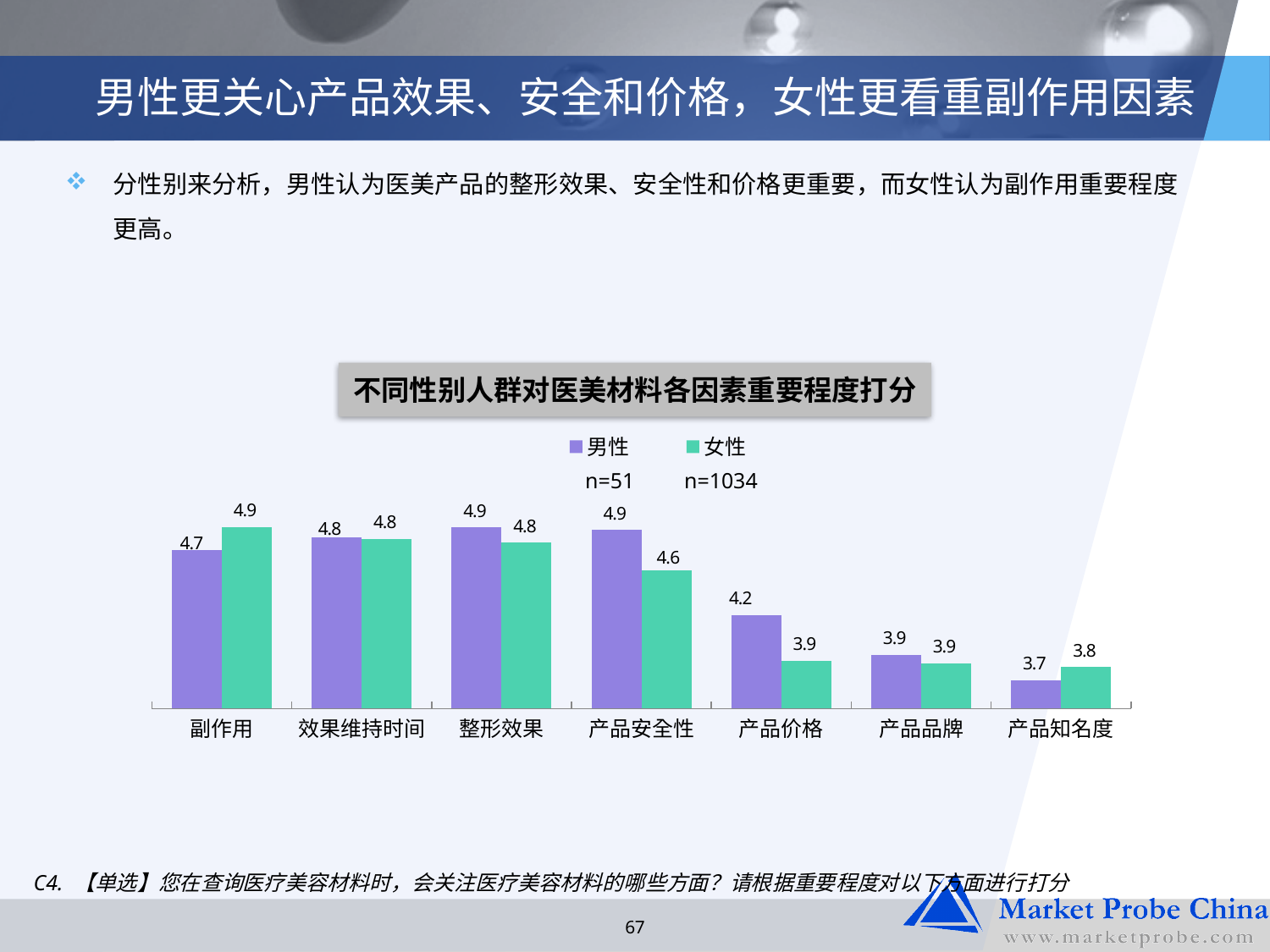
What is the 女性 score for 产品价格? 3.9 How many series does the legend list? 2 What is the 女性 score for 产品安全性? 4.6 What is the 男性 score for 副作用? 4.7 For 产品价格, which is larger, the 男性 score or the 女性 score? 男性 Which category has the highest 女性 score? 副作用 Which category has the lowest 男性 score? 产品知名度 How many categories are shown on the x axis? 7 What is the title of the chart? 不同性别人群对医美材料各因素重要程度打分 What is the sample size (n) for the 女性 series? n=1034 What kind of chart is shown? bar chart What is the difference between the 男性 and 女性 scores for 产品安全性? 0.3